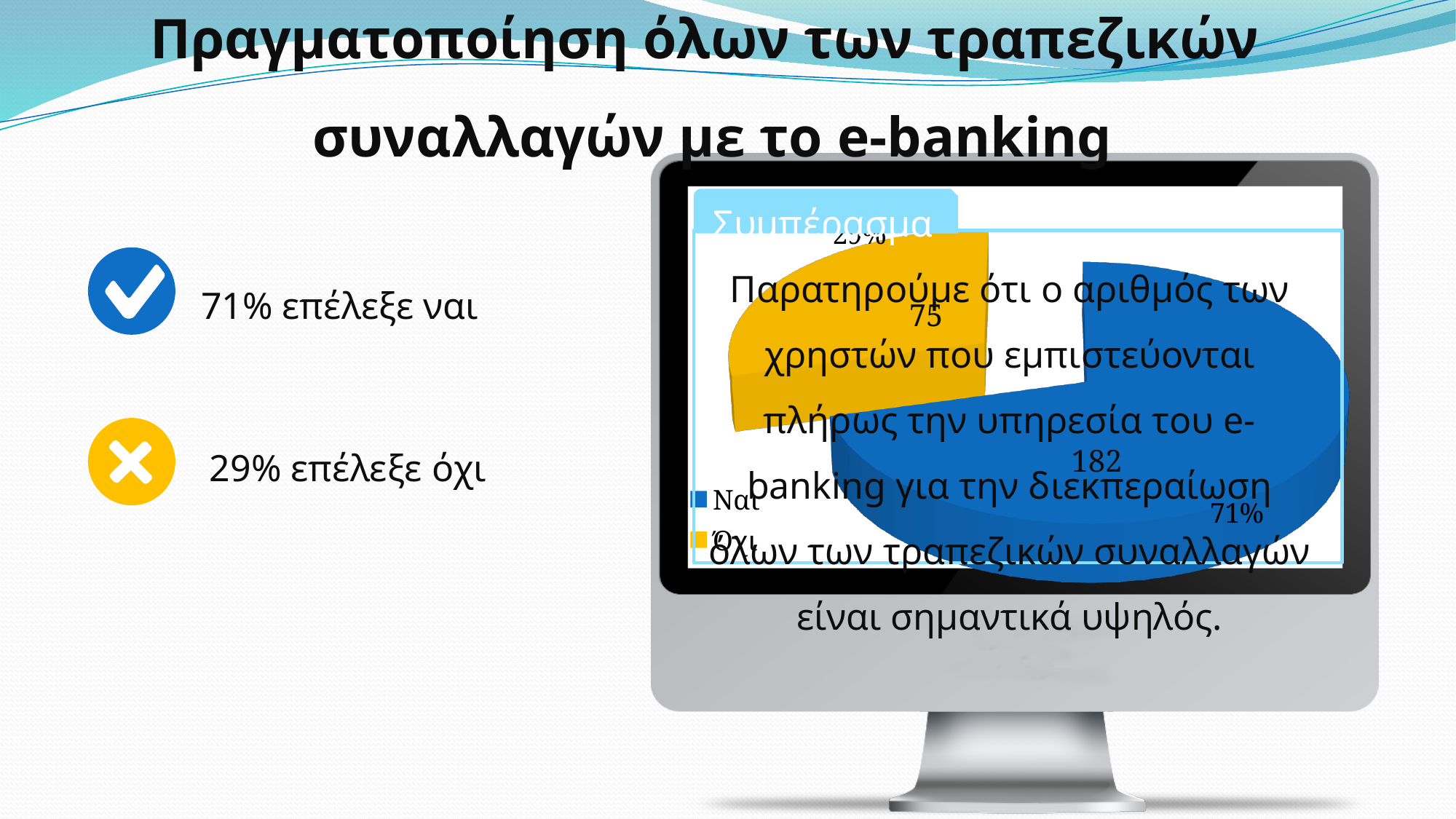
What percentage share of the pie does the Όχι slice represent? 29% How many entries does the legend of the pie chart list? 2 What percentage share of the pie does the Ναι slice represent? 71% Which slice of the pie chart is the smallest? Όχι Which slice of the pie chart is the largest? Ναι What is the difference between the Ναι and Όχι values in the pie chart? 107 What kind of chart is shown on the slide? pie chart How many slices does the pie chart have? 2 What is the value shown for the Ναι slice of the pie chart? 182 Which is larger in the pie chart, Ναι or Όχι? Ναι What is the value shown for the Όχι slice of the pie chart? 75 What colour is the Όχι slice in the pie chart? yellow